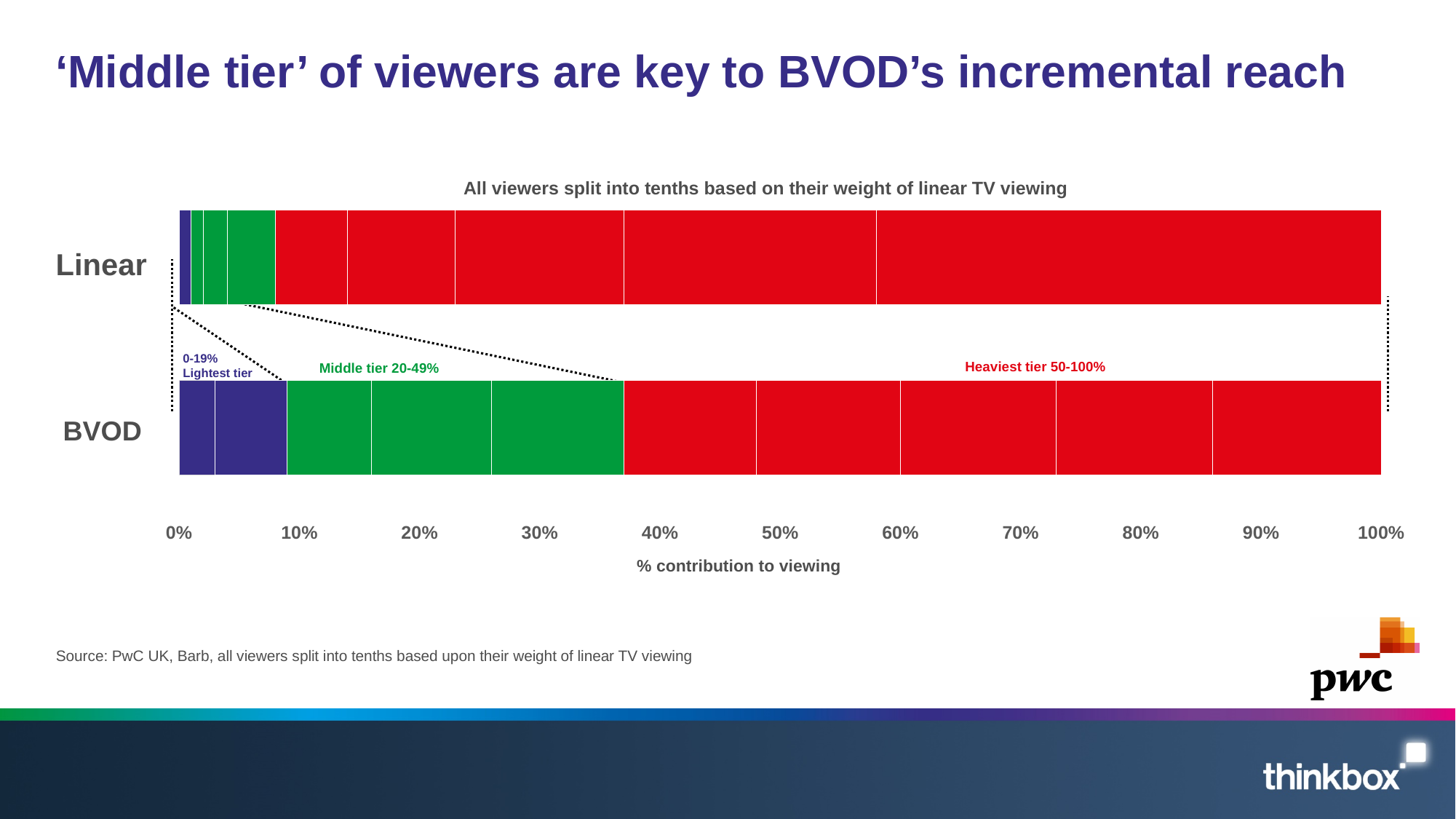
Which bar has the larger contribution to viewing from the middle tier (20-49%), Linear or BVOD? BVOD Is the contribution of the heaviest tier (50-100%) in the Linear bar greater or less than 90%? greater Is the combined contribution of the lightest and middle tiers in the Linear bar greater or less than 10%? less What is the label of the horizontal axis? % contribution to viewing What are the two categories plotted on the chart? Linear and BVOD Is the combined contribution of the lightest and middle tiers in the BVOD bar greater or less than 40%? less How many bars (categories) does the chart show? 2 What is the title of the chart? All viewers split into tenths based on their weight of linear TV viewing What kind of chart is shown on the slide? Stacked bar chart Which bar has the larger contribution to viewing from the heaviest tier (50-100%), Linear or BVOD? Linear